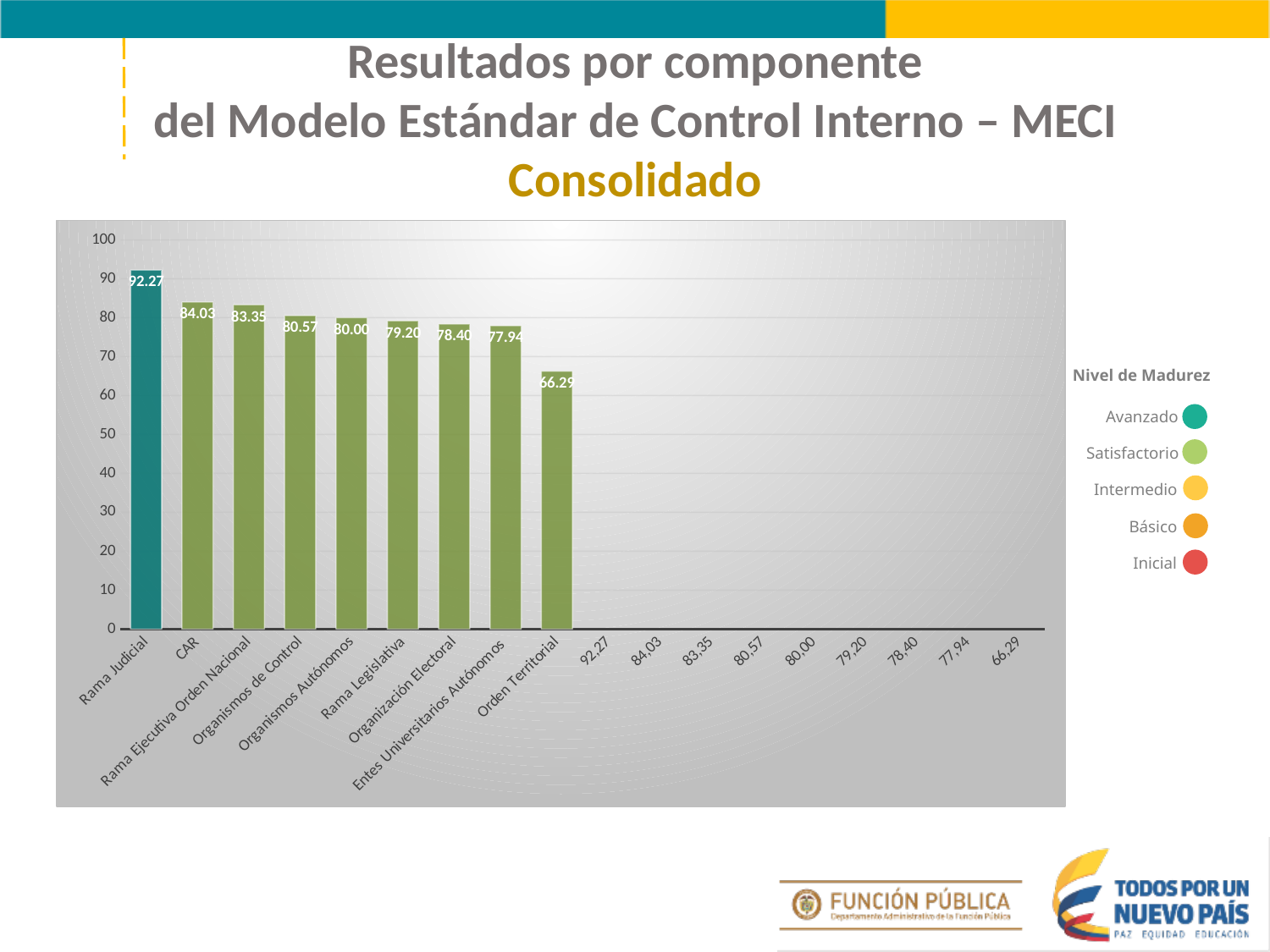
What is the value for Rama Legislativa? 79.20 Which category has the lowest value? Orden Territorial What kind of chart is shown on the slide? Bar chart What is the value for Orden Territorial? 66.29 What is the value for Organismos de Control? 80.57 Which category has the highest value? Rama Judicial What is the difference between the values for Rama Judicial and Orden Territorial? 25.98 How many maturity levels does the 'Nivel de Madurez' legend list? 5 Which is larger, the value for CAR or the value for Organismos Autónomos? CAR What is the difference between the values for CAR and Rama Ejecutiva Orden Nacional? 0.68 What is the value for Rama Judicial? 92.27 How many bars are plotted in the chart? 9